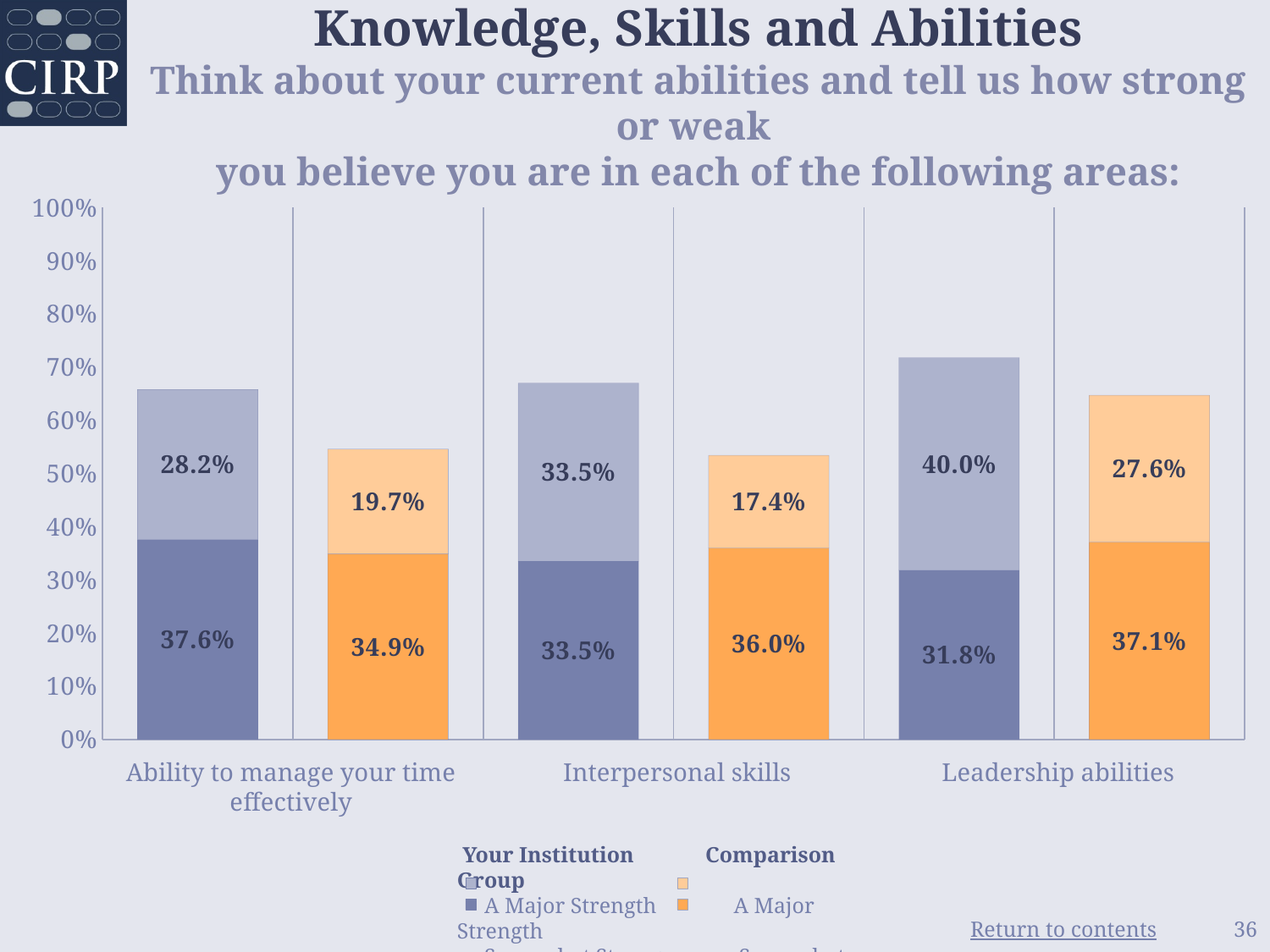
Which category has the highest 'A Major Strength' value for the Comparison Group? Leadership abilities What is the upper (lighter) segment value for the Comparison Group's 'Ability to manage your time effectively' bar? 19.7% Which category has the lowest 'A Major Strength' value for Your Institution? Ability to manage your time effectively How many categories are shown on the x axis of the chart? 3 What percentage of Your Institution respondents rated 'Ability to manage your time effectively' as A Major Strength? 28.2% What is the total height of Your Institution's stacked bar for Leadership abilities? 71.8% What is the total height of the Comparison Group's stacked bar for Interpersonal skills? 53.4% What is the upper (lighter) segment value for Your Institution's Leadership abilities bar? 40.0% What kind of chart is shown on the slide? Stacked bar chart What is the Comparison Group's 'A Major Strength' value for Interpersonal skills? 17.4% For Interpersonal skills, which group has the larger 'A Major Strength' value, Your Institution or the Comparison Group? Your Institution What is the difference between Your Institution's and the Comparison Group's 'A Major Strength' values for Leadership abilities? 12.4%